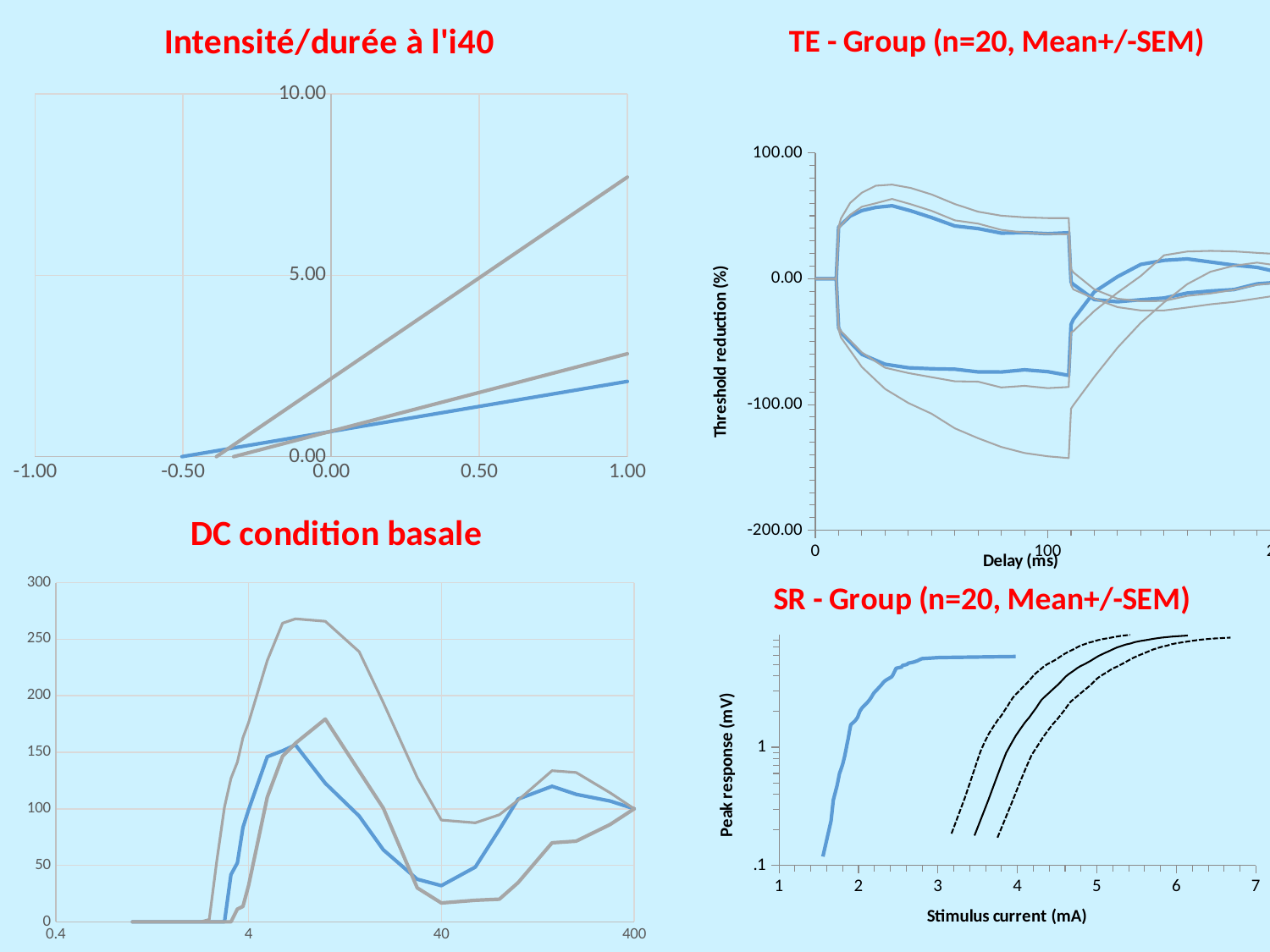
In the "Intensité/durée à l'i40" chart, is the value of the blue line at x = 1.00 greater or less than 5.00? less What is the x-axis label of the "SR - Group (n=20, Mean+/-SEM)" chart? Stimulus current (mA) What kind of chart is "Intensité/durée à l'i40"? line chart How many lines are plotted in the "Intensité/durée à l'i40" chart? 3 In the "Intensité/durée à l'i40" chart, do the lines rise or fall as x increases from 0.00 to 1.00? rise In the "TE - Group (n=20, Mean+/-SEM)" chart, is the lower blue line at a delay of 50 ms greater or less than -50.00? less In the "DC condition basale" chart, is the peak of the upper grey line greater or less than 250? greater In the "DC condition basale" chart, what value do the lines reach at x = 400? 100 What kind of chart is "DC condition basale"? line chart What is the y-axis label of the "TE - Group (n=20, Mean+/-SEM)" chart? Threshold reduction (%)